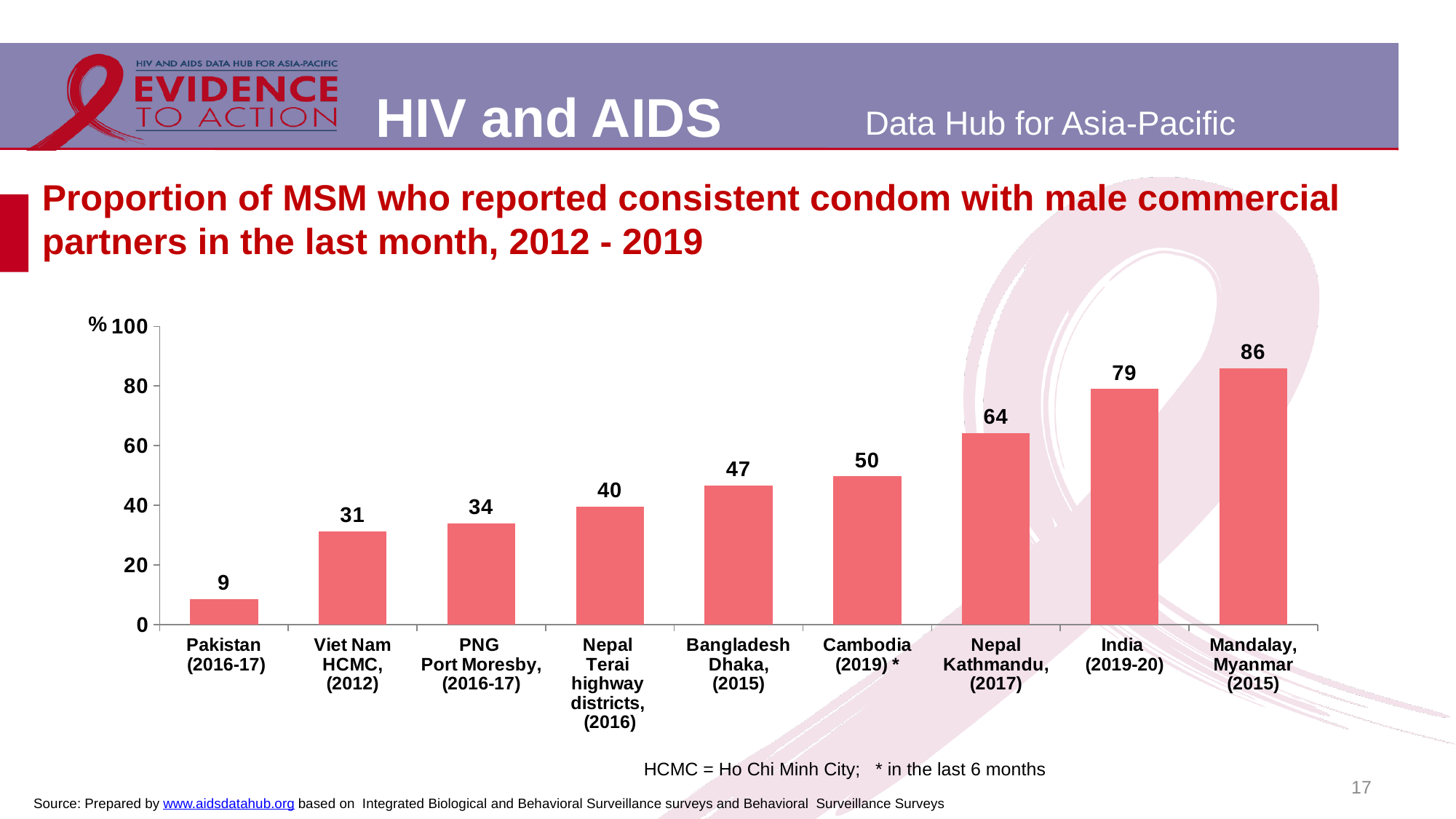
What does HCMC stand for according to the note below the chart? Ho Chi Minh City Is the value for Nepal Terai highway districts (2016) greater or less than 60? less What kind of chart is shown on the slide? bar chart How many categories are shown on the chart? 9 Which category has the highest value? Mandalay, Myanmar (2015) Which category has the lowest value? Pakistan (2016-17) Which is larger, the value for Bangladesh Dhaka (2015) or the value for PNG Port Moresby (2016-17)? Bangladesh Dhaka (2015) What is the value for Pakistan (2016-17)? 9 Do the values rise or fall from left to right along the x axis? rise What is the difference between the values for India (2019-20) and Viet Nam HCMC (2012)? 48 What is the value for Nepal Kathmandu (2017)? 64 What is the value for Cambodia (2019)? 50